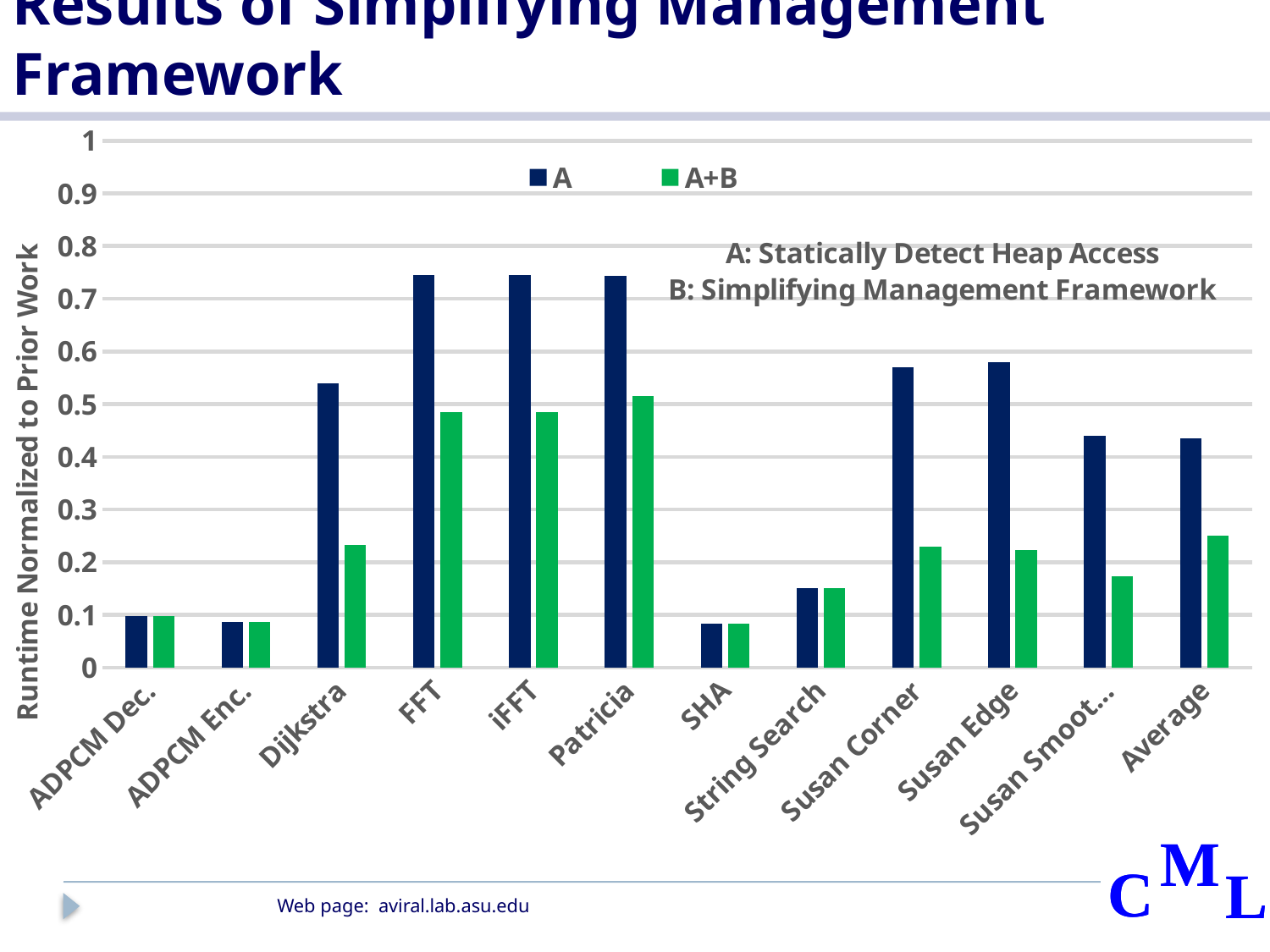
What is the label of the y axis? Runtime Normalized to Prior Work How many categories are shown on the x axis? 12 Is the value of series A for Dijkstra greater or less than 0.5? greater For Dijkstra, which series has the larger value, A or A+B? A What kind of chart is shown on the slide? bar chart For series A+B, which is larger, Patricia or Dijkstra? Patricia What are the two legend entries of the chart? A and A+B Is the value of series A+B for FFT greater or less than 0.5? less Is the value of series A for Average greater or less than 0.4? greater How many series does the legend list? 2